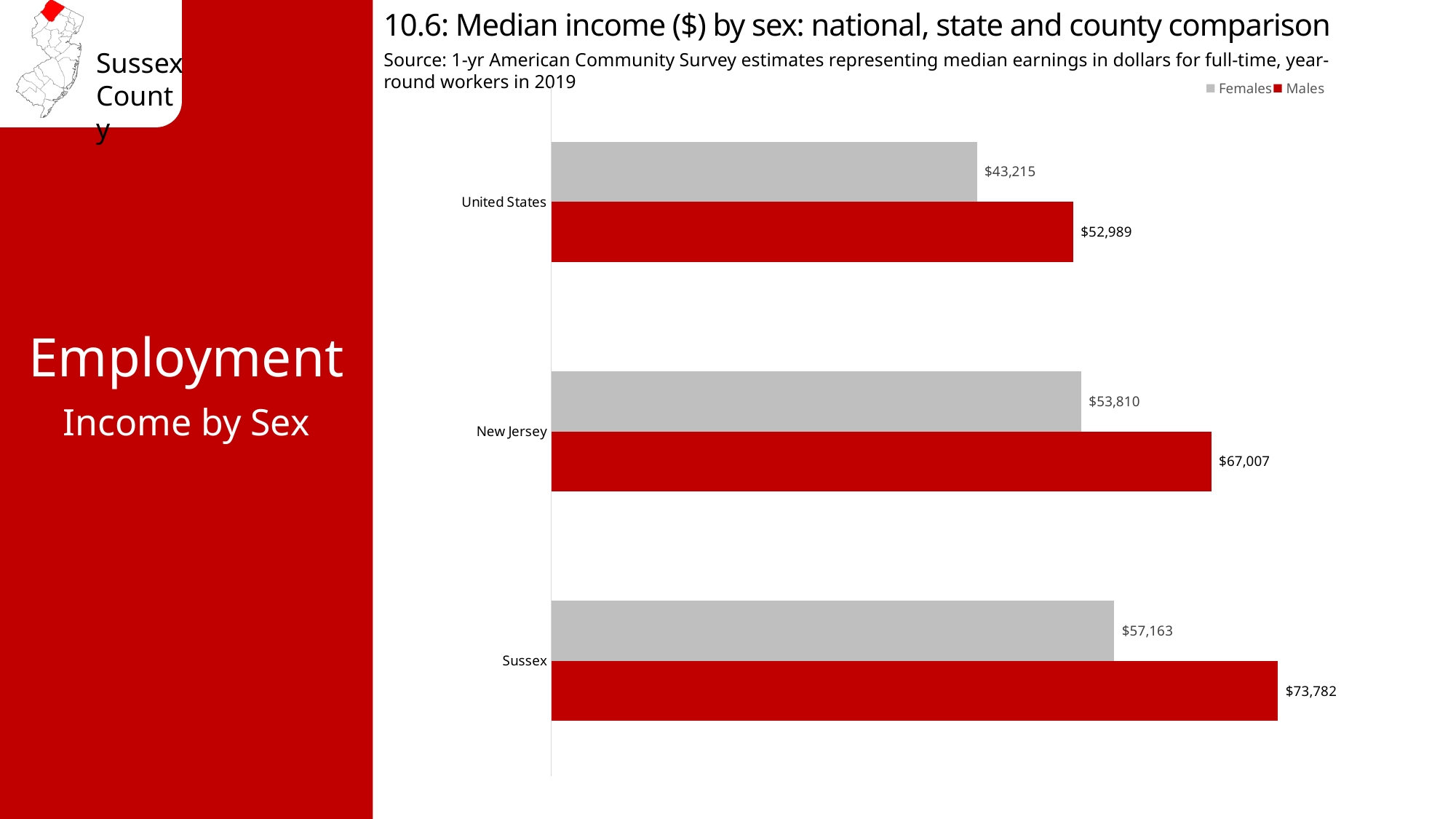
Which category has the lowest median income for Females? United States How many categories are shown on the chart? 3 What is the median income for Females in the United States? $43,215 What is the median income for Males in New Jersey? $67,007 What kind of chart is shown on the slide? Bar chart How many series does the legend list? 2 What is the difference between the Males and Females median income in Sussex? $16,619 What is the median income for Females in Sussex? $57,163 What is the difference between the Males median income in New Jersey and in the United States? $14,018 Which category has the highest median income for Males? Sussex What is the median income for Males in Sussex? $73,782 Which is larger: the Females median income in New Jersey or the Males median income in the United States? Females median income in New Jersey